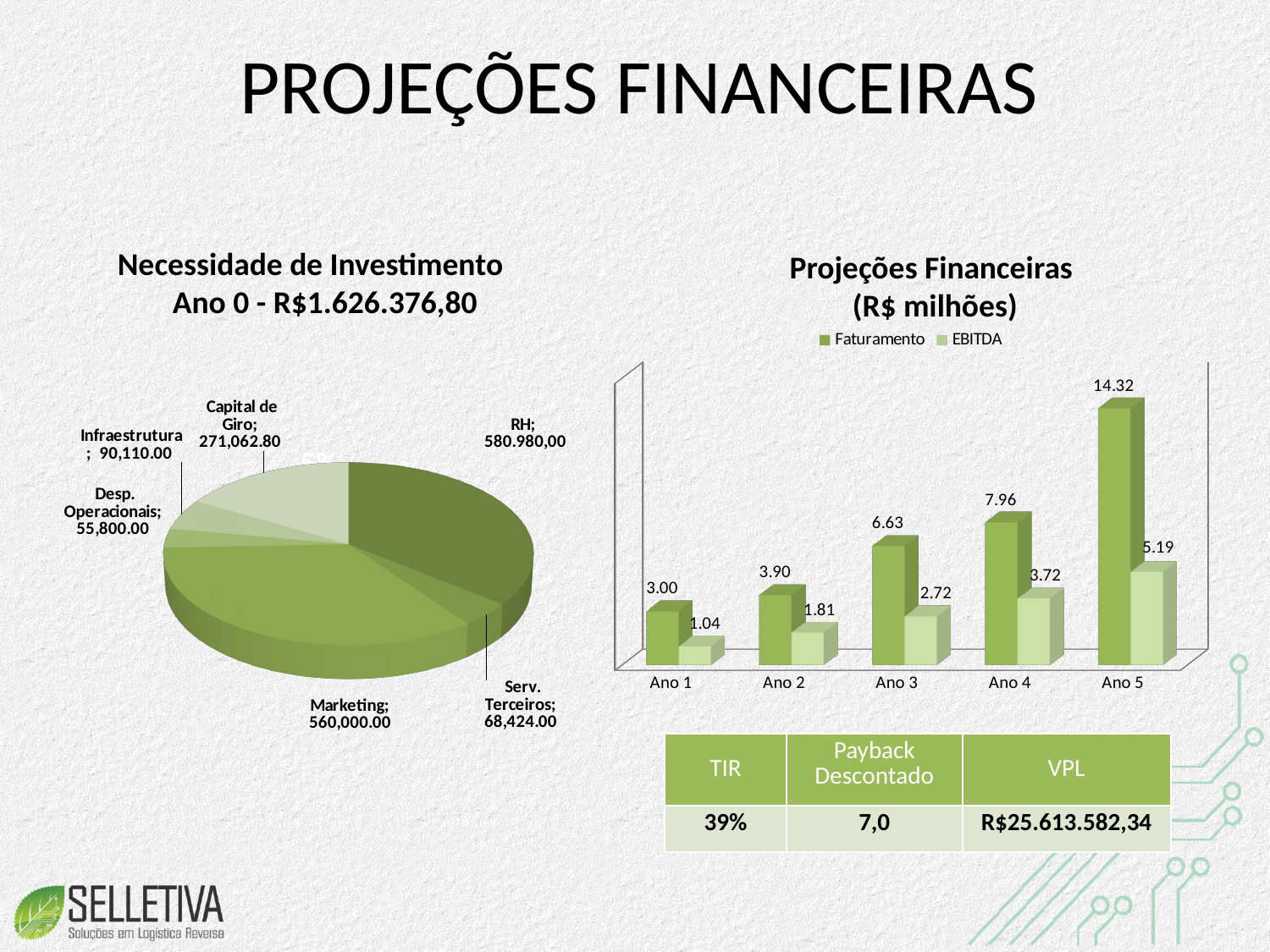
In the 'Necessidade de Investimento' pie chart, what is the value for Marketing? 560,000.00 In the 'Projeções Financeiras (R$ milhões)' chart, what is the difference between Faturamento in Ano 5 and Ano 4? 6.36 In the 'Projeções Financeiras (R$ milhões)' chart, does EBITDA rise or fall from Ano 1 to Ano 5? rise In the 'Necessidade de Investimento' pie chart, how many slices are there? 6 In the 'Projeções Financeiras (R$ milhões)' chart, what is the Faturamento value for Ano 3? 6.63 In the 'Projeções Financeiras (R$ milhões)' chart, which year has the highest Faturamento? Ano 5 What type of chart is the 'Projeções Financeiras (R$ milhões)' chart on the right? bar chart In the 'Projeções Financeiras (R$ milhões)' chart, what is the EBITDA value for Ano 4? 3.72 In the 'Necessidade de Investimento' pie chart, which category has the smallest value? Desp. Operacionais How many series does the legend of the 'Projeções Financeiras (R$ milhões)' chart list? 2 In the 'Necessidade de Investimento' pie chart, what is the value for Capital de Giro? 271,062.80 What type of chart is the 'Necessidade de Investimento' chart on the left? pie chart